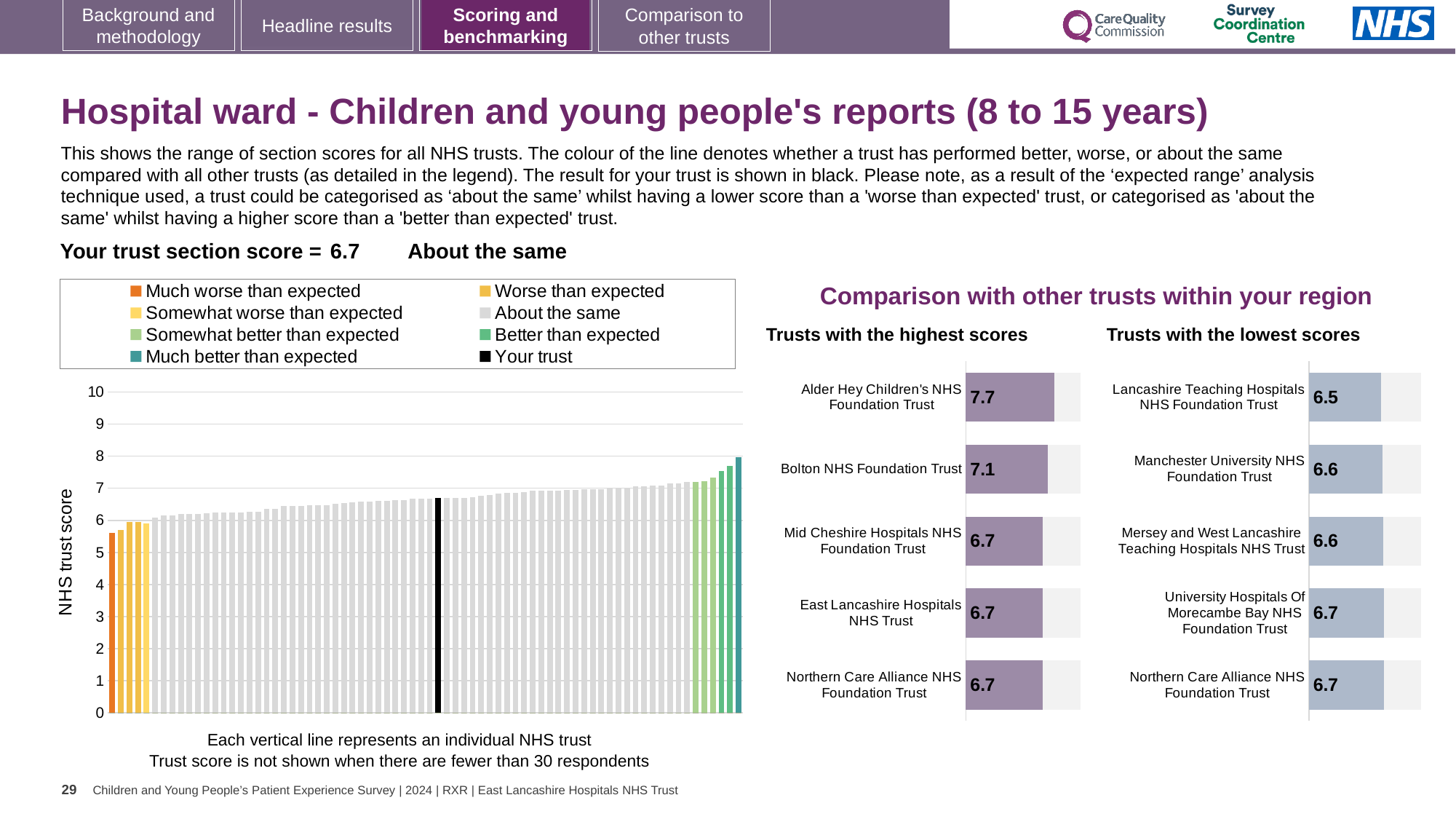
In the 'Trusts with the lowest scores' chart, what is the difference between the scores of Northern Care Alliance NHS Foundation Trust and Lancashire Teaching Hospitals NHS Foundation Trust? 0.2 In the 'Trusts with the highest scores' chart, which trust has the highest score? Alder Hey Children's NHS Foundation Trust In the 'Trusts with the lowest scores' chart, which trust has the lowest score? Lancashire Teaching Hospitals NHS Foundation Trust In the large chart of NHS trust scores on the left, what is the score of the black bar representing your trust? 6.7 In the 'Trusts with the highest scores' chart, what is the score for Alder Hey Children's NHS Foundation Trust? 7.7 Which has the higher score: Alder Hey Children's NHS Foundation Trust in the highest scores chart or Manchester University NHS Foundation Trust in the lowest scores chart? Alder Hey Children's NHS Foundation Trust How many trusts are listed in the 'Trusts with the lowest scores' chart? 5 In the large chart of NHS trust scores on the left, do the bar values rise or fall from left to right? rise In the large chart of NHS trust scores on the left, is the value of the tallest bar greater or less than 7? greater In the 'Trusts with the lowest scores' chart, what is the score for Lancashire Teaching Hospitals NHS Foundation Trust? 6.5 In the 'Trusts with the highest scores' chart, what is the difference between the scores of Alder Hey Children's NHS Foundation Trust and Bolton NHS Foundation Trust? 0.6 In the 'Trusts with the highest scores' chart, what is the score for Bolton NHS Foundation Trust? 7.1